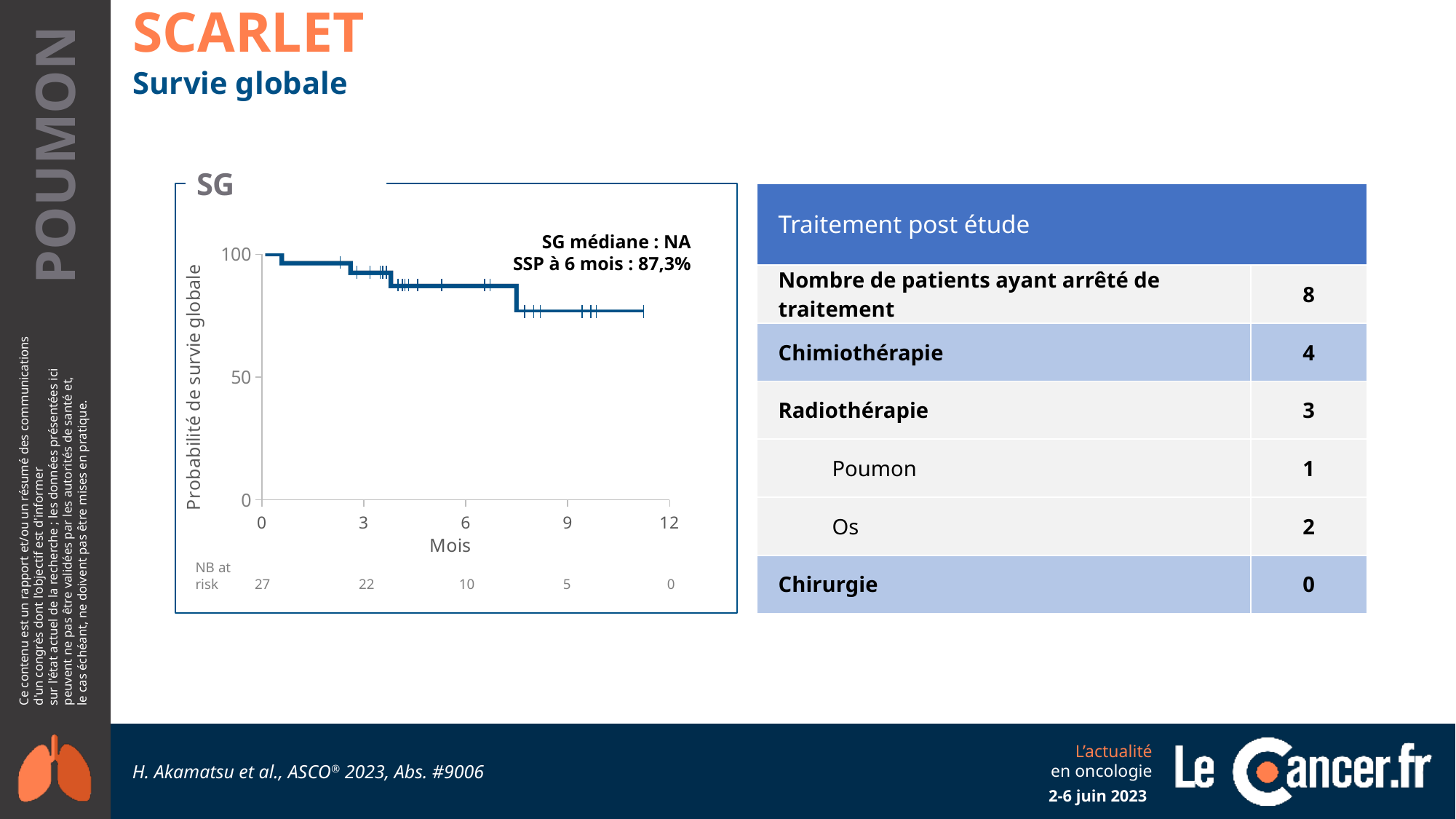
In the SG chart, how many patients are at risk at 6 months? 10 In the SG chart, what is the difference between the number at risk at 0 months and at 3 months? 5 In the SG chart, how many patients are at risk (NB at risk) at 0 months? 27 In the SG chart, what value is given for SSP à 6 mois? 87,3% What is the label of the x axis of the SG chart? Mois In the SG chart, is the survival probability at 9 months greater or less than 50? greater In the SG chart, how many patients are at risk at 12 months? 0 What kind of chart is the SG chart on the slide? line chart In the SG chart, what is the median overall survival (SG médiane) shown? NA What is the label of the y axis of the SG chart? Probabilité de survie globale In the SG chart, does the survival curve rise or fall as months increase? fall In the SG chart, how many time points are listed in the NB at risk row? 5